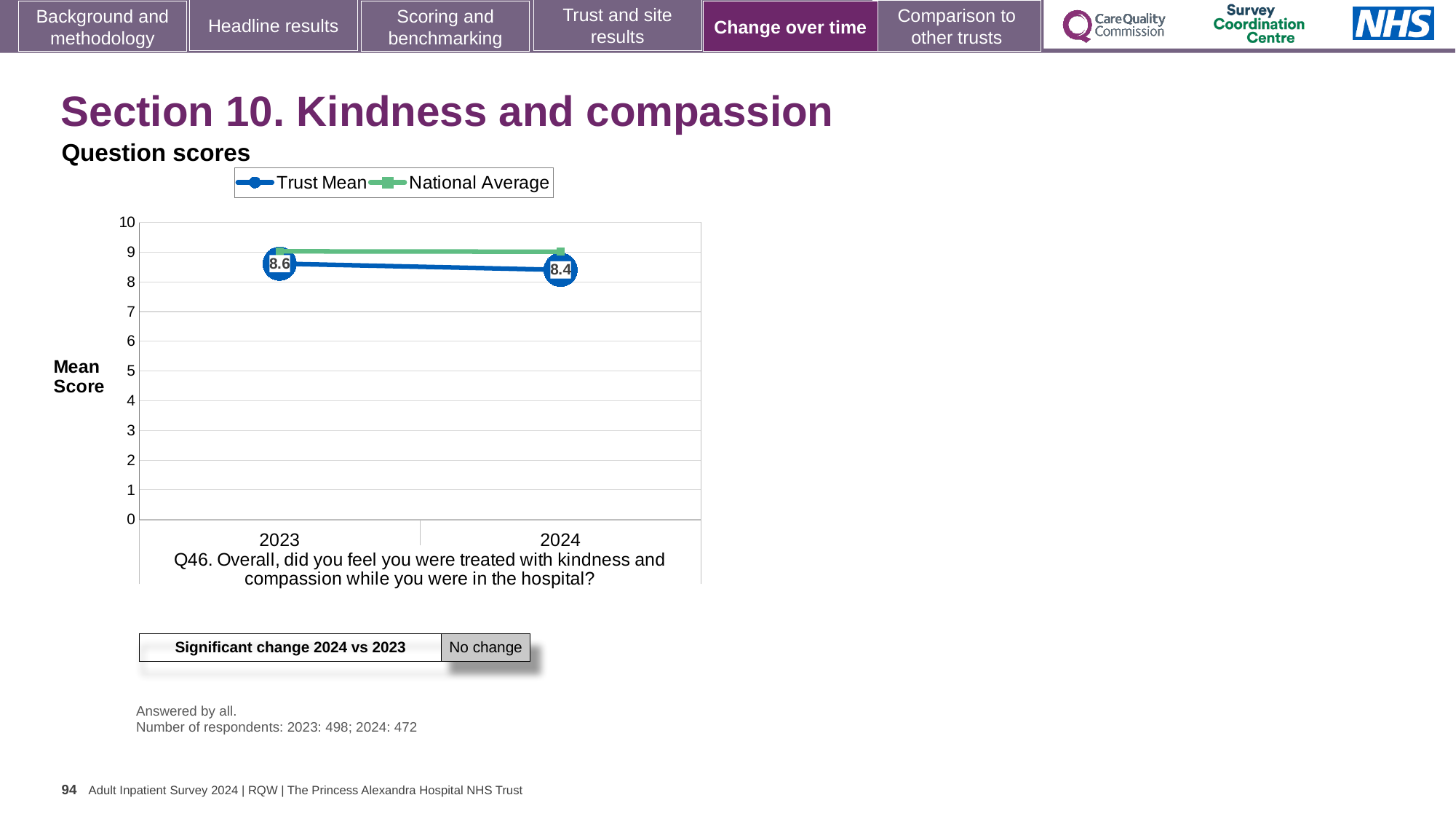
How many series does the legend list? 2 In which year is the Trust Mean score lowest? 2024 What is the Trust Mean score for 2024? 8.4 What kind of chart is shown on the slide? line chart What is the Trust Mean score for 2023? 8.6 By how much did the Trust Mean score change from 2023 to 2024? 0.2 What is the label on the y axis of the chart? Mean Score Is the National Average value for 2024 greater or less than 8? greater Which series is higher in 2024, Trust Mean or National Average? National Average How many years are plotted on the x axis? 2 Which year has the higher Trust Mean score, 2023 or 2024? 2023 Does the Trust Mean line rise or fall from 2023 to 2024? fall